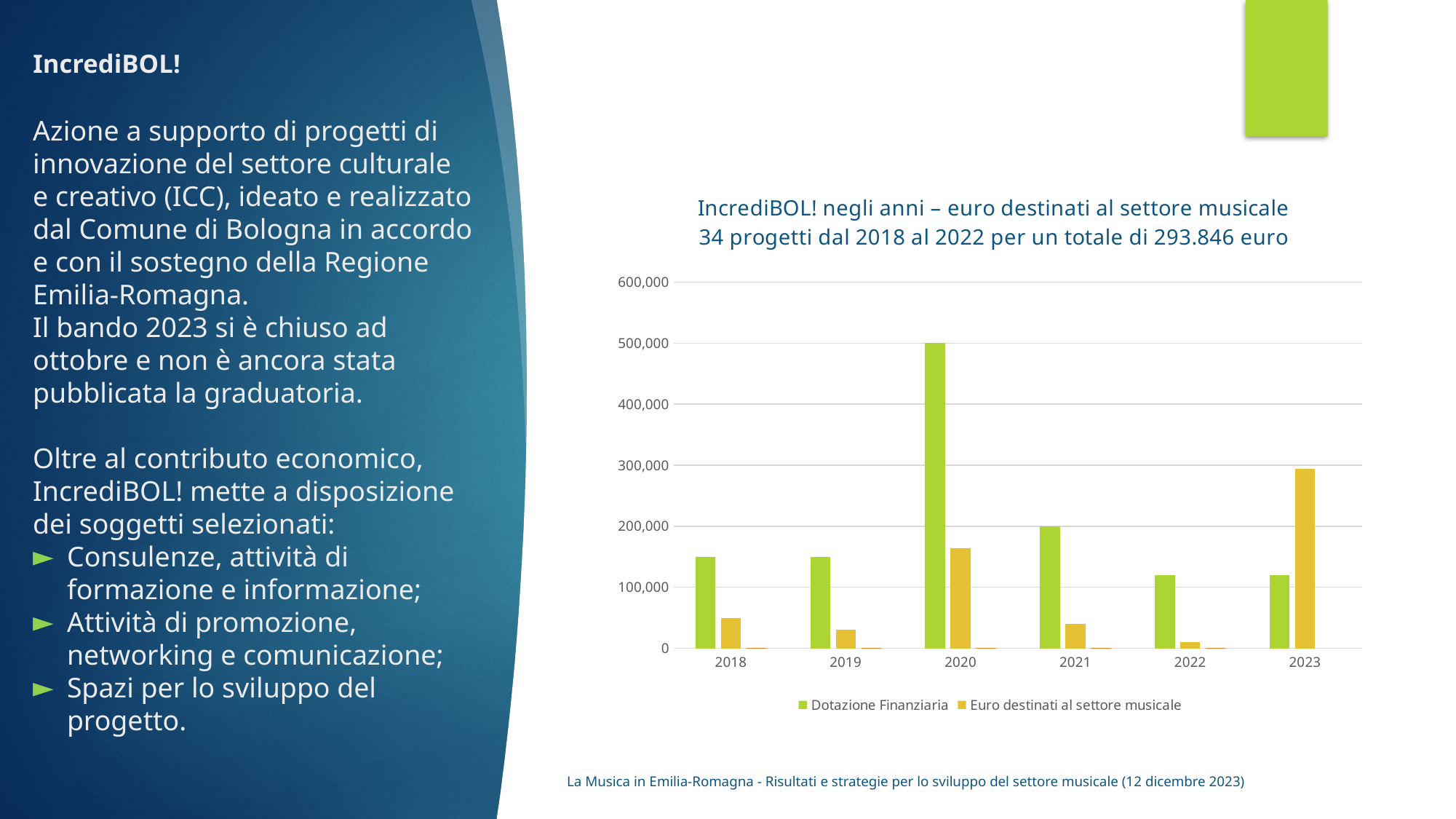
Is the Dotazione Finanziaria for 2020 greater or less than 400,000? greater Is the Dotazione Finanziaria for 2018 greater or less than 200,000? less What is the first line of the chart's title? IncrediBOL! negli anni – euro destinati al settore musicale How many series does the chart legend list? 2 What kind of chart is shown on the slide? bar chart In which year is the Dotazione Finanziaria highest? 2020 How many years are shown on the x axis of the chart? 6 Which year has the larger value for Euro destinati al settore musicale, 2018 or 2019? 2018 Which year has the larger Dotazione Finanziaria, 2020 or 2021? 2020 In which year is the value for Euro destinati al settore musicale lowest? 2022 In which year is the value for Euro destinati al settore musicale highest? 2023 Is the value for Euro destinati al settore musicale in 2023 greater or less than 200,000? greater